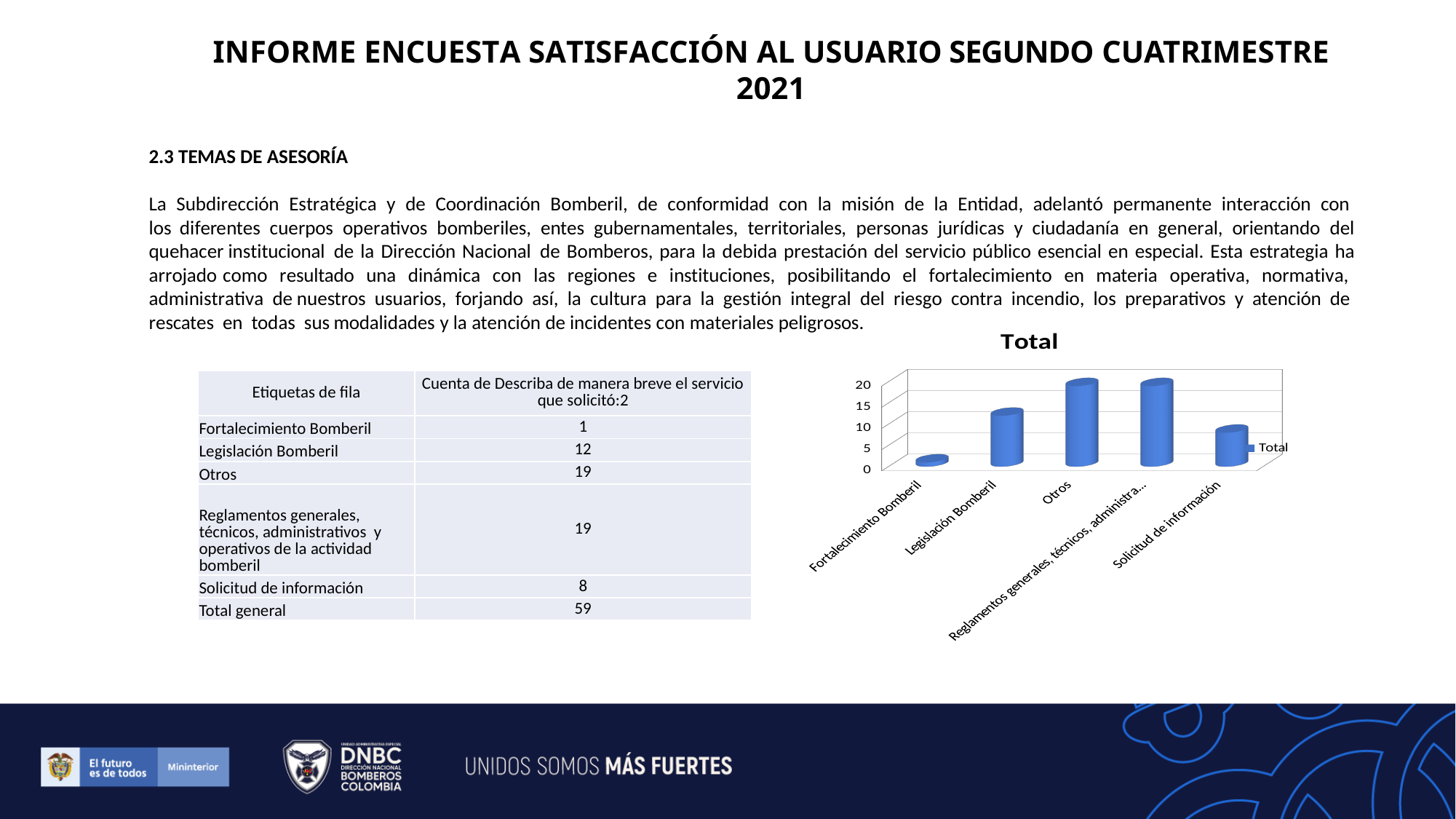
What is the value for Solicitud de información? 8 How many categories are plotted on the x axis of the chart? 5 What is the title of the chart? Total What is the difference between the value for Otros and the value for Legislación Bomberil? 7 What kind of chart is shown on the slide? bar chart How many series does the chart legend list? 1 Which category has the lowest value in the chart? Fortalecimiento Bomberil Is the value for Solicitud de información greater or less than 10? less What is the value for Otros? 19 What is the value for Legislación Bomberil? 12 Is the value for Legislación Bomberil greater or less than 10? greater Which is larger, the value for Legislación Bomberil or the value for Solicitud de información? Legislación Bomberil